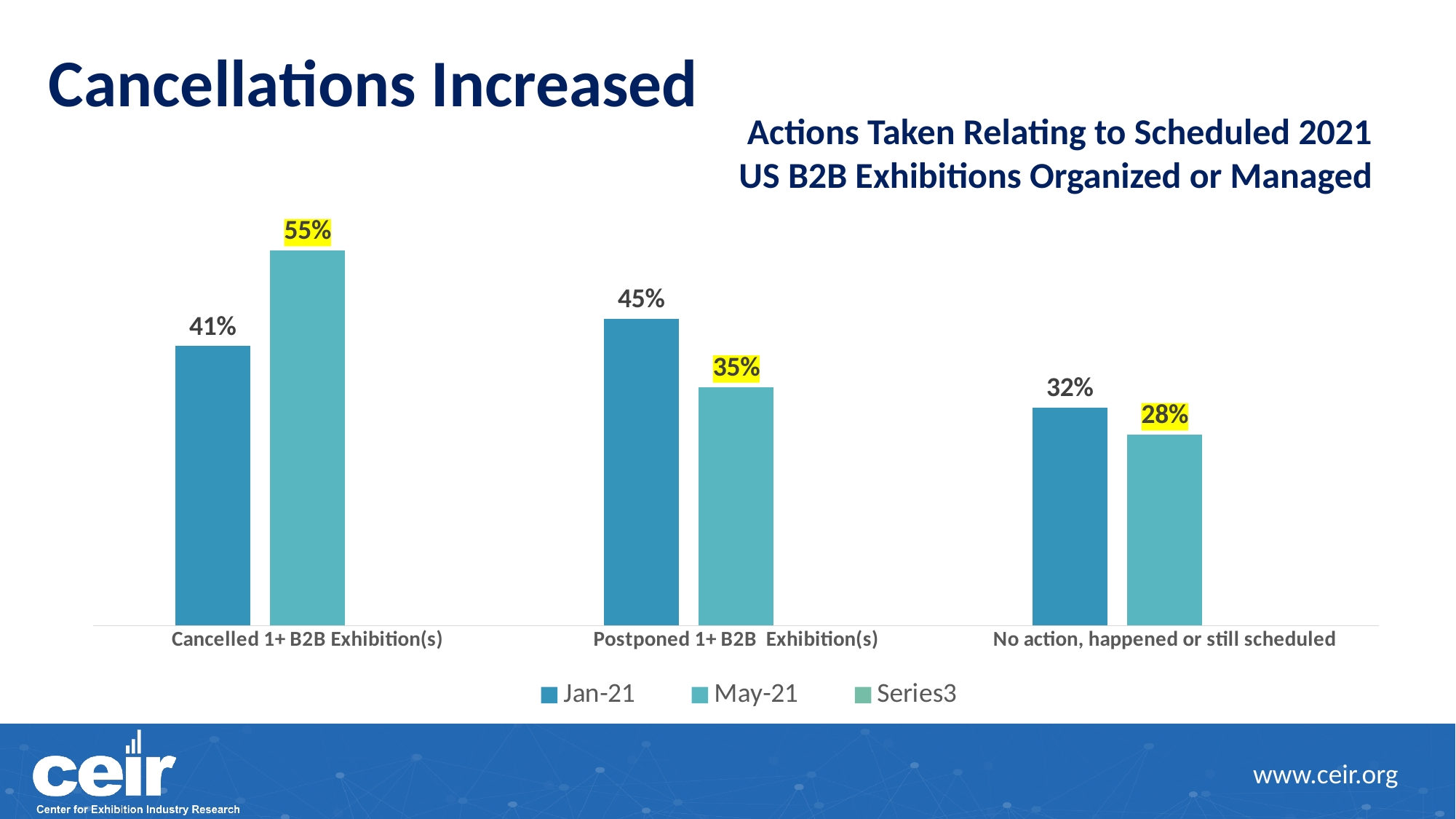
What is the difference between the May-21 and Jan-21 values for Cancelled 1+ B2B Exhibition(s)? 14% For No action, happened or still scheduled, which is larger: the Jan-21 value or the May-21 value? Jan-21 What kind of chart is shown on the slide? Bar chart What is the May-21 value for Cancelled 1+ B2B Exhibition(s)? 55% What is the Jan-21 value for Cancelled 1+ B2B Exhibition(s)? 41% Which category has the lowest Jan-21 value? No action, happened or still scheduled What is the difference between the Jan-21 and May-21 values for Postponed 1+ B2B Exhibition(s)? 10% What is the May-21 value for No action, happened or still scheduled? 28% How many series does the legend list? 3 How many categories are shown on the x axis? 3 What is the Jan-21 value for Postponed 1+ B2B Exhibition(s)? 45% Which category has the highest May-21 value? Cancelled 1+ B2B Exhibition(s)